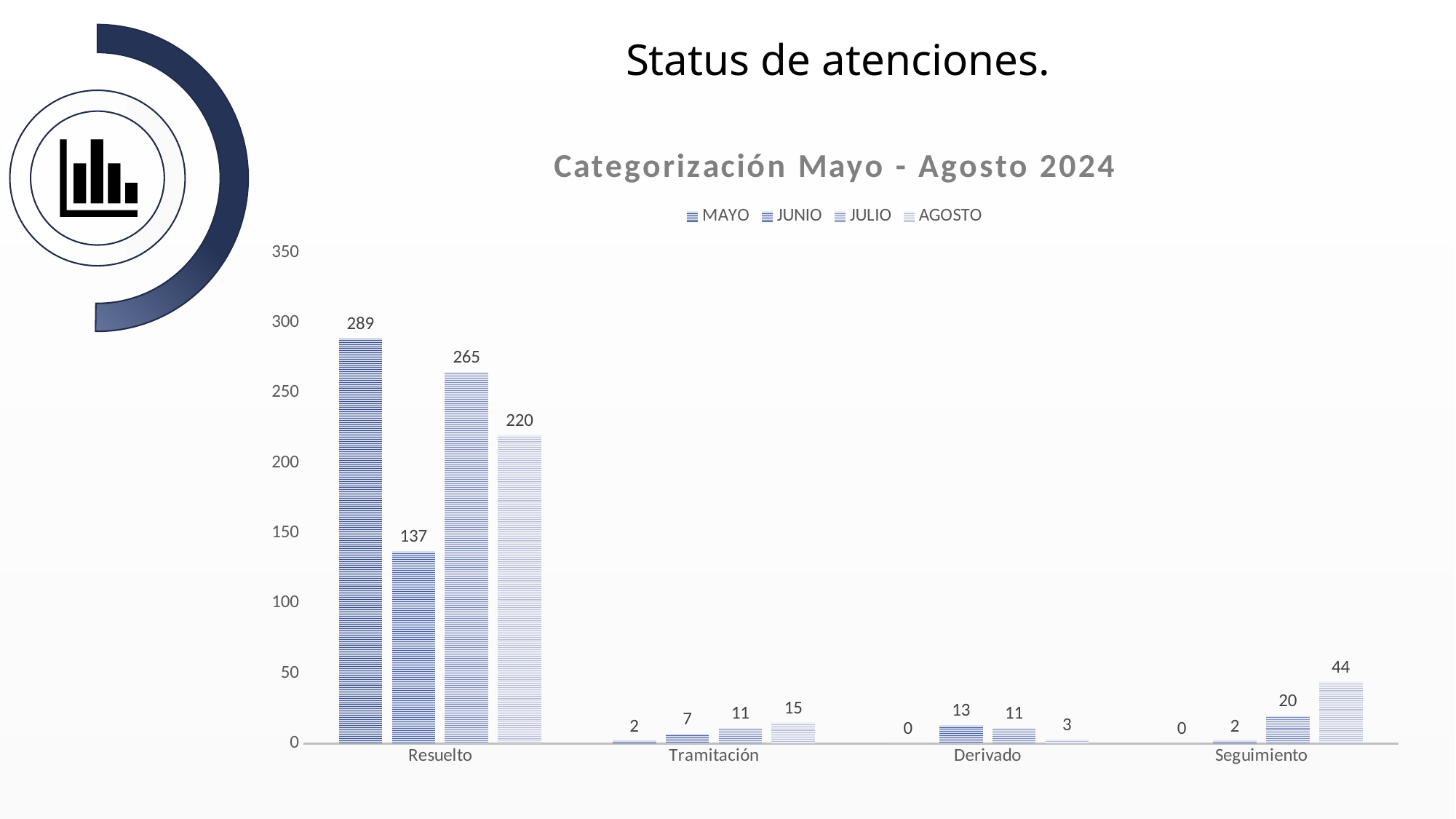
Is the value for JUNIO in Resuelto greater or less than 150? less What is the title of the chart? Categorización Mayo - Agosto 2024 What is the difference between the MAYO and JUNIO values for Resuelto? 152 Which month has the highest value in the Resuelto category? MAYO Which month has the lowest value in the Tramitación category? MAYO What kind of chart is shown on the slide? bar chart How many categories are shown on the x axis? 4 What is the value for JUNIO in the Derivado category? 13 Which is larger, the JULIO value for Resuelto or the AGOSTO value for Resuelto? JULIO What is the value for MAYO in the Resuelto category? 289 What is the value for AGOSTO in the Seguimiento category? 44 How many series does the legend list? 4